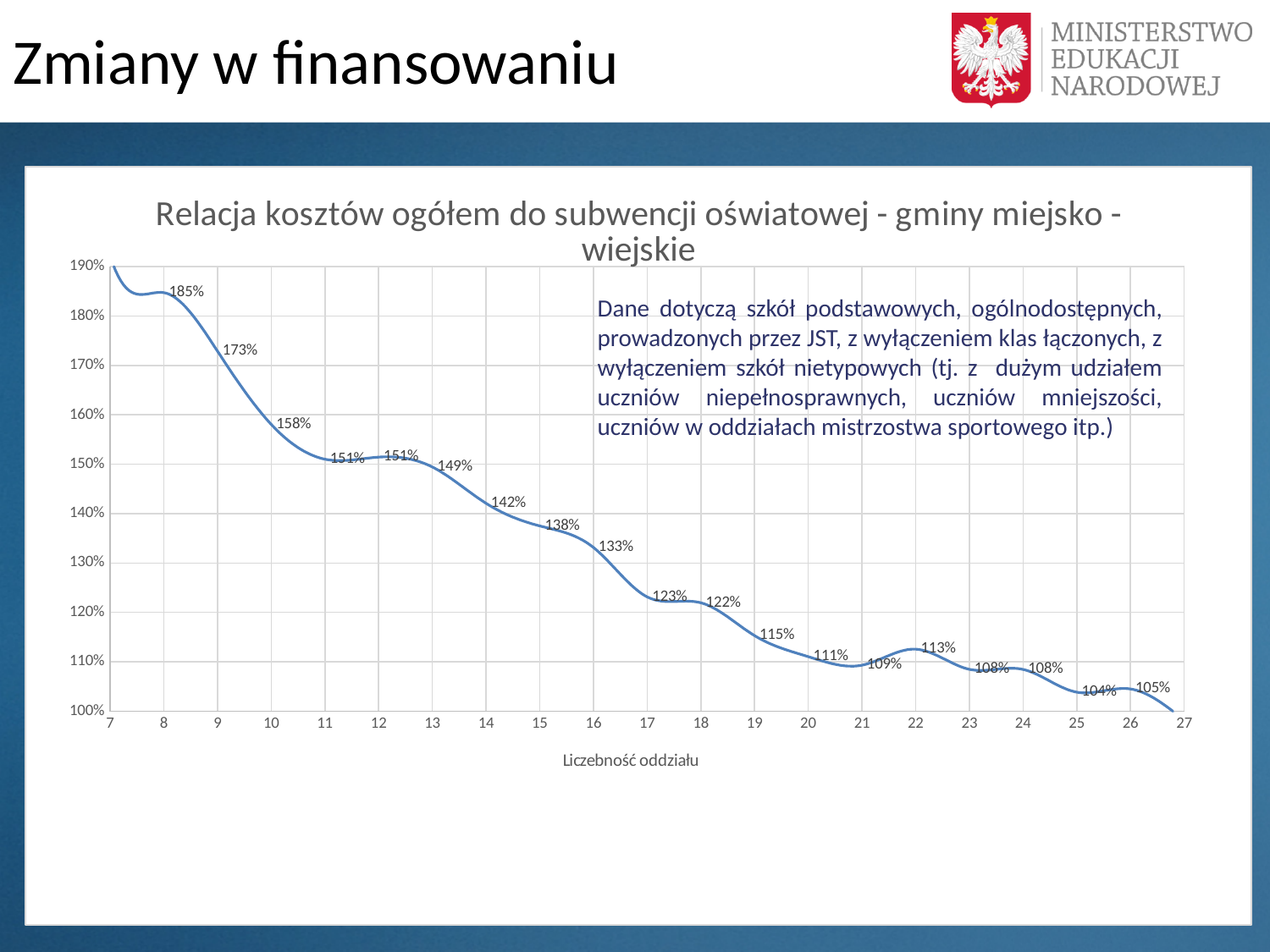
What is the value for a class size (Liczebność oddziału) of 9? 173% Is the value for class size 7 greater or less than 180%? greater What is the difference between the values for class sizes 16 and 17? 10 percentage points What is the label of the x axis? Liczebność oddziału What type of chart is shown on the slide? line chart What is the value for a class size of 22? 113% What is the difference between the values for class sizes 8 and 10? 27 percentage points What is the value for a class size of 25? 104% Does the value generally rise or fall as class size increases along the x axis? fall What is the value for a class size of 19? 115% What is the value for a class size of 14? 142% Which is larger, the value for class size 21 or class size 22? class size 22